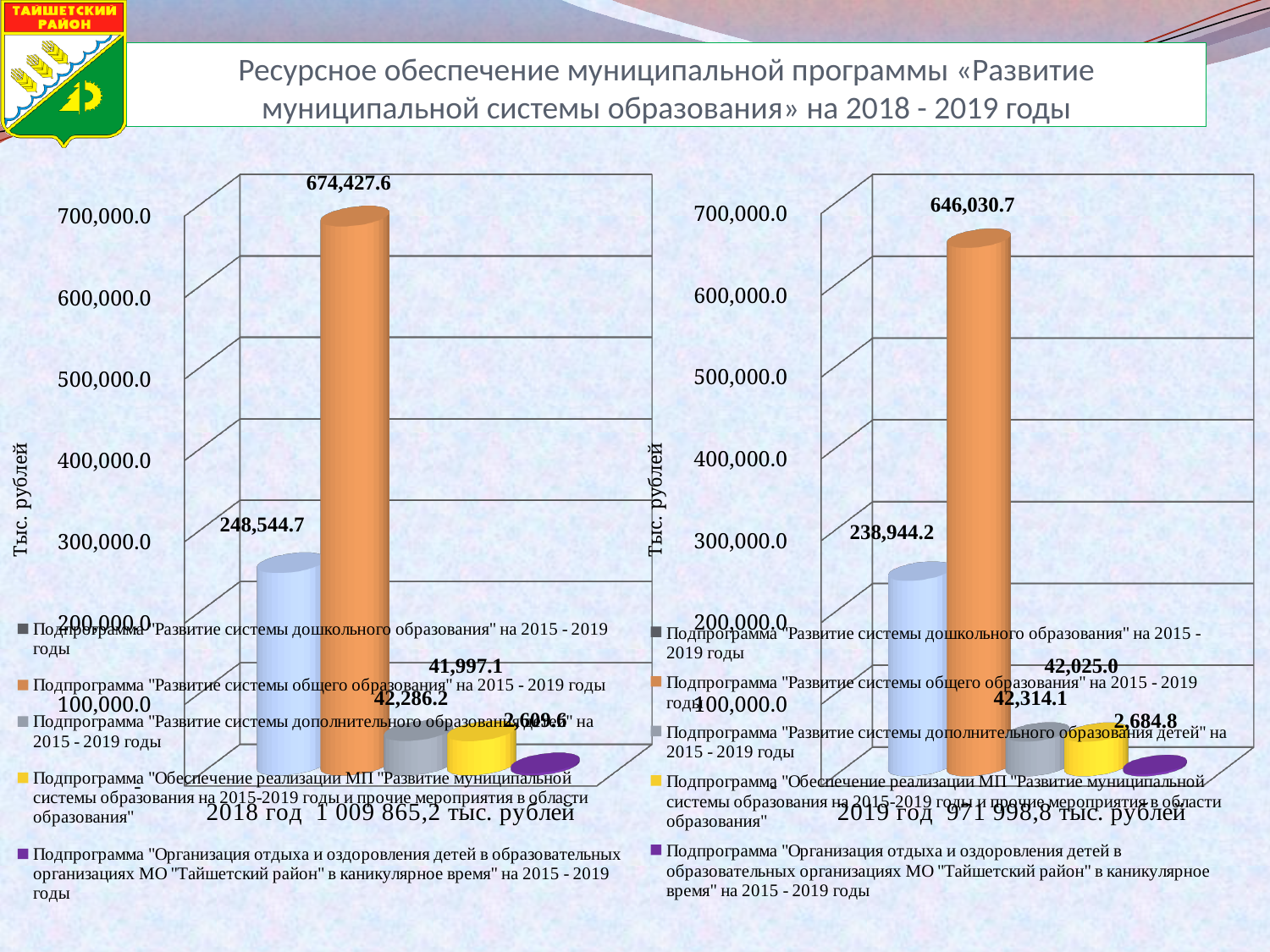
In the 2018 год chart, is the value for дошкольного образования greater or less than 200,000.0? greater In the 2019 год chart, what is the value for Подпрограмма "Развитие системы общего образования"? 646,030.7 What type of chart is the 2018 год chart? Bar chart Which is larger: the дошкольного образования value in the 2018 год chart or in the 2019 год chart? 2018 год What is the difference between the общего образования values in the 2018 год chart and the 2019 год chart? 28,396.9 In the 2018 год chart, what is the value for Подпрограмма "Развитие системы общего образования"? 674,427.6 In the 2018 год chart, which subprogram has the highest value? Подпрограмма "Развитие системы общего образования" In the 2019 год chart, what is the value for Подпрограмма "Развитие системы дошкольного образования"? 238,944.2 How many series does the legend of the 2019 год chart list? 5 In the 2019 год chart, what is the value for Подпрограмма "Организация отдыха и оздоровления детей"? 2,684.8 In the 2018 год chart, what is the value for Подпрограмма "Развитие системы дошкольного образования"? 248,544.7 In the 2019 год chart, which subprogram has the lowest value? Подпрограмма "Организация отдыха и оздоровления детей в образовательных организациях МО "Тайшетский район" в каникулярное время"